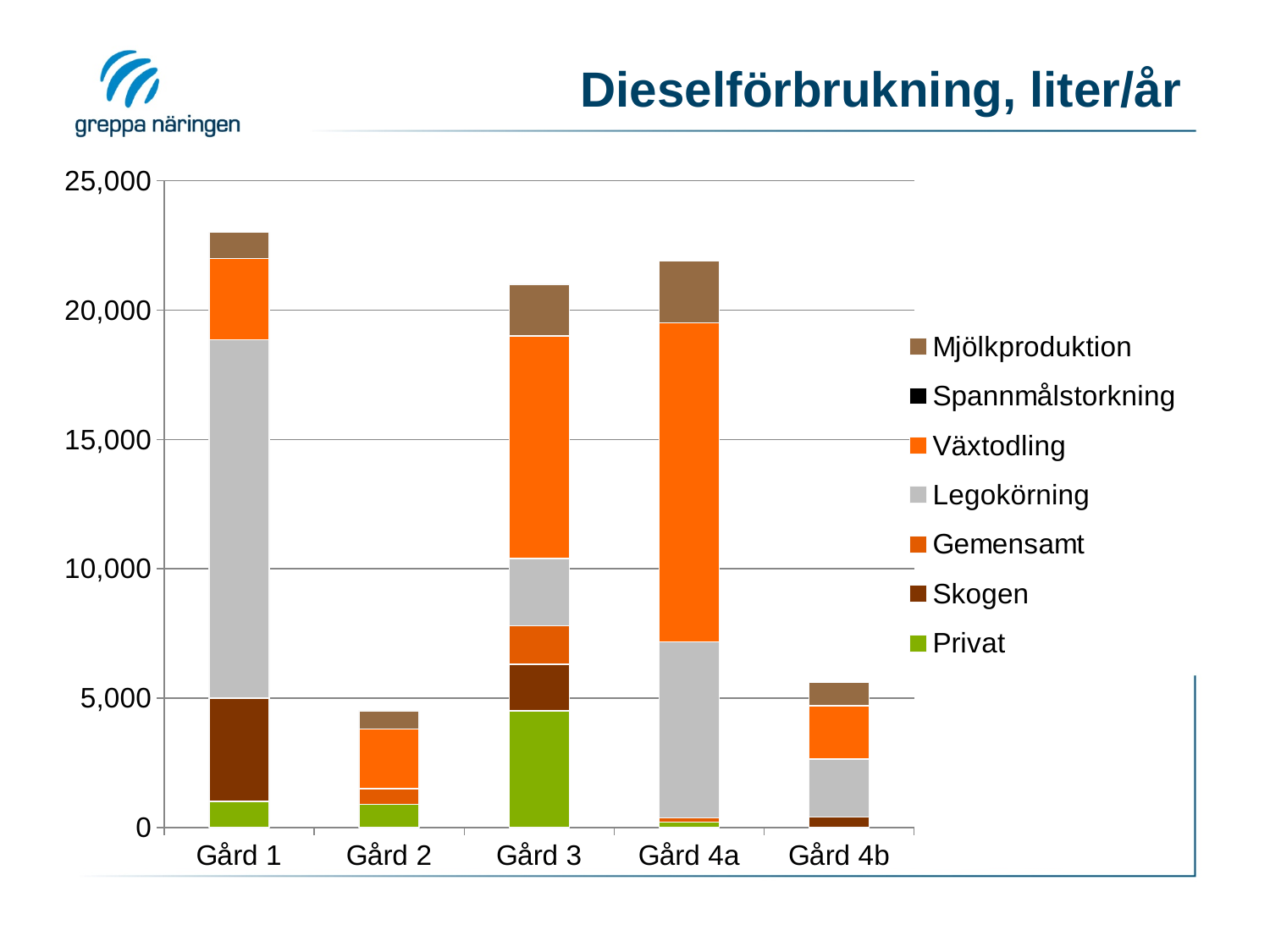
Is the total value for Gård 4a greater or less than 20,000? greater Which farm has the highest total diesel consumption? Gård 1 Is the total value for Gård 4b greater or less than 5,000? greater Which legend entry is shown in green? Privat Is the total value for Gård 3 greater or less than 20,000? greater Which farm has the lowest total diesel consumption? Gård 2 How many series does the legend list? 7 What is the title of the chart? Dieselförbrukning, liter/år Which has the larger total diesel consumption, Gård 3 or Gård 2? Gård 3 How many farms (categories) are shown on the x axis? 5 What kind of chart is shown on the slide? Stacked bar chart